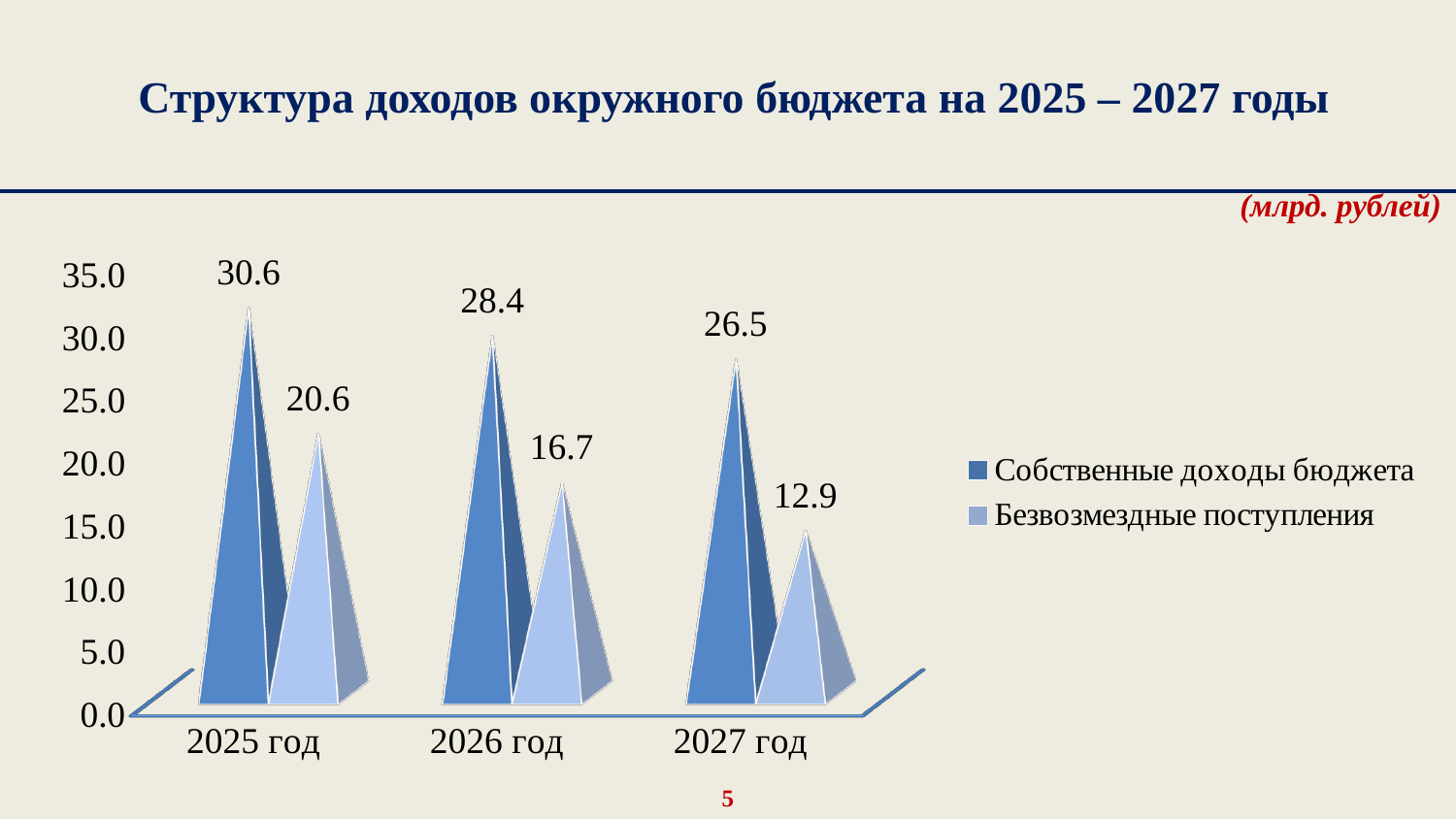
What is the value for Безвозмездные поступления in 2027 год? 12.9 In which year is Собственные доходы бюджета the lowest? 2027 год In which year is Безвозмездные поступления the highest? 2025 год What is the value for Собственные доходы бюджета in 2025 год? 30.6 How many years are shown on the x axis? 3 Which is larger in 2027 год: Собственные доходы бюджета or Безвозмездные поступления? Собственные доходы бюджета What unit is stated for the values on the chart? млрд. рублей Do the values for Безвозмездные поступления rise or fall from 2025 год to 2027 год? Fall How many series does the legend list? 2 What kind of chart is shown on the slide? Bar chart What is the value for Безвозмездные поступления in 2026 год? 16.7 What is the difference between Собственные доходы бюджета and Безвозмездные поступления in 2026 год? 11.7